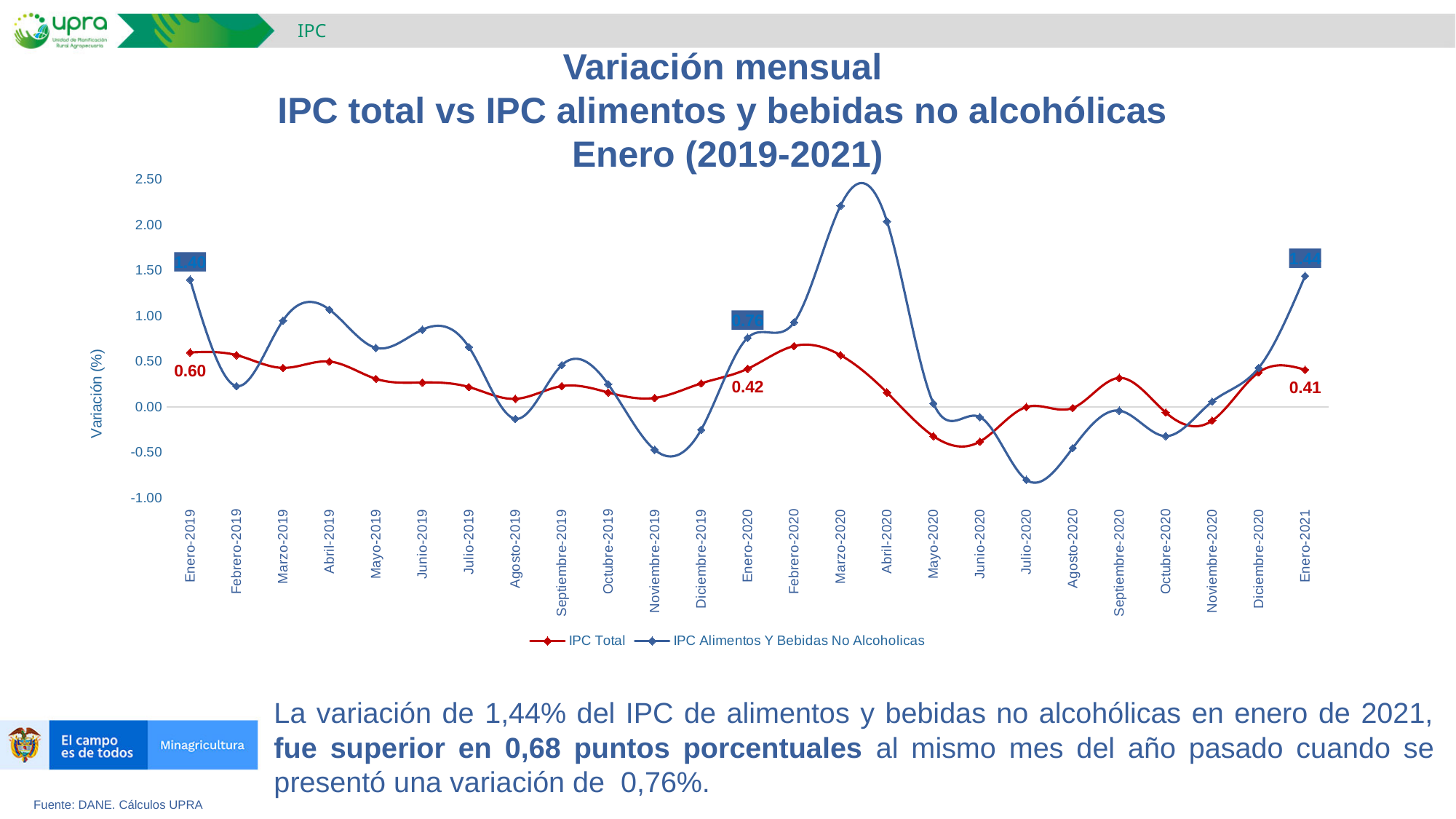
How many series does the legend list? 2 What is the IPC Alimentos Y Bebidas No Alcoholicas value for Enero-2021? 1.44 What is the difference between the IPC Total values for Enero-2019 and Enero-2021? 0.19 What kind of chart is shown on the slide? Line chart In Enero-2021, which series has the higher value, IPC Total or IPC Alimentos Y Bebidas No Alcoholicas? IPC Alimentos Y Bebidas No Alcoholicas In which month does the IPC Alimentos Y Bebidas No Alcoholicas series reach its highest value? Marzo-2020 Is the IPC Alimentos Y Bebidas No Alcoholicas value for Julio-2020 greater or less than -0.50? less Is the IPC Alimentos Y Bebidas No Alcoholicas value for Marzo-2020 greater or less than 2.00? greater What is the IPC Total value for Enero-2019? 0.60 How many months are plotted along the x axis? 25 What is the IPC Total value for Enero-2020? 0.42 What is the IPC Total value for Enero-2021? 0.41